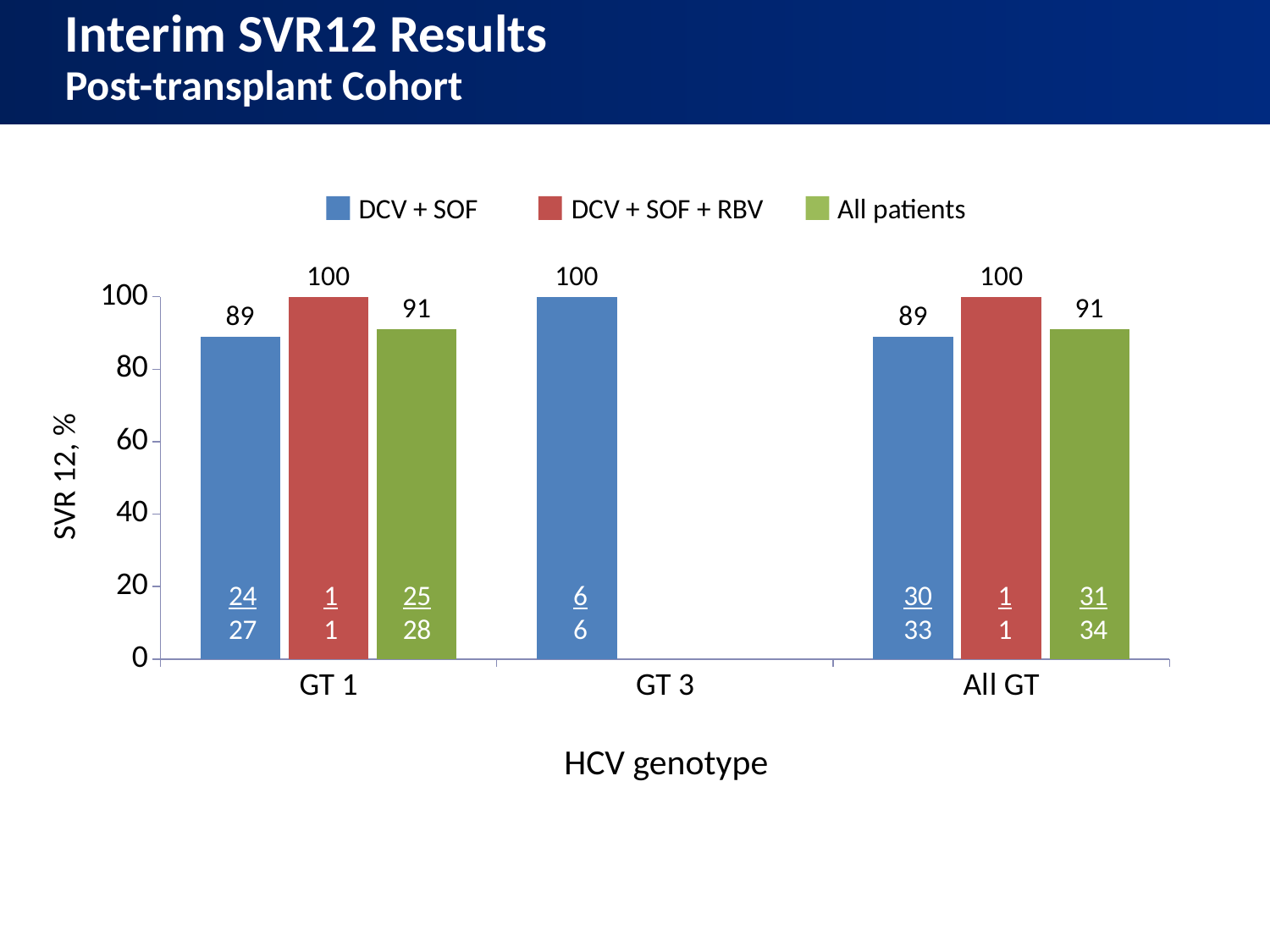
What fraction of patients is shown inside the DCV + SOF bar for GT 3? 6/6 Which series has the highest SVR12 rate in the GT 1 group? DCV + SOF + RBV What is the label of the y axis? SVR 12, % What is the SVR12 rate for DCV + SOF in the GT 3 group? 100 Which series has the lowest SVR12 rate in the All GT group? DCV + SOF What is the difference in SVR12 rate between DCV + SOF + RBV and DCV + SOF in the GT 1 group? 11 What is the SVR12 rate for All patients in the All GT group? 91 What kind of chart is shown on the slide? Bar chart How many series does the legend list? 3 How many HCV genotype categories are shown on the x axis? 3 Which is larger in the All GT group: the SVR12 rate for DCV + SOF or for All patients? All patients What is the SVR12 rate for DCV + SOF in the GT 1 group? 89